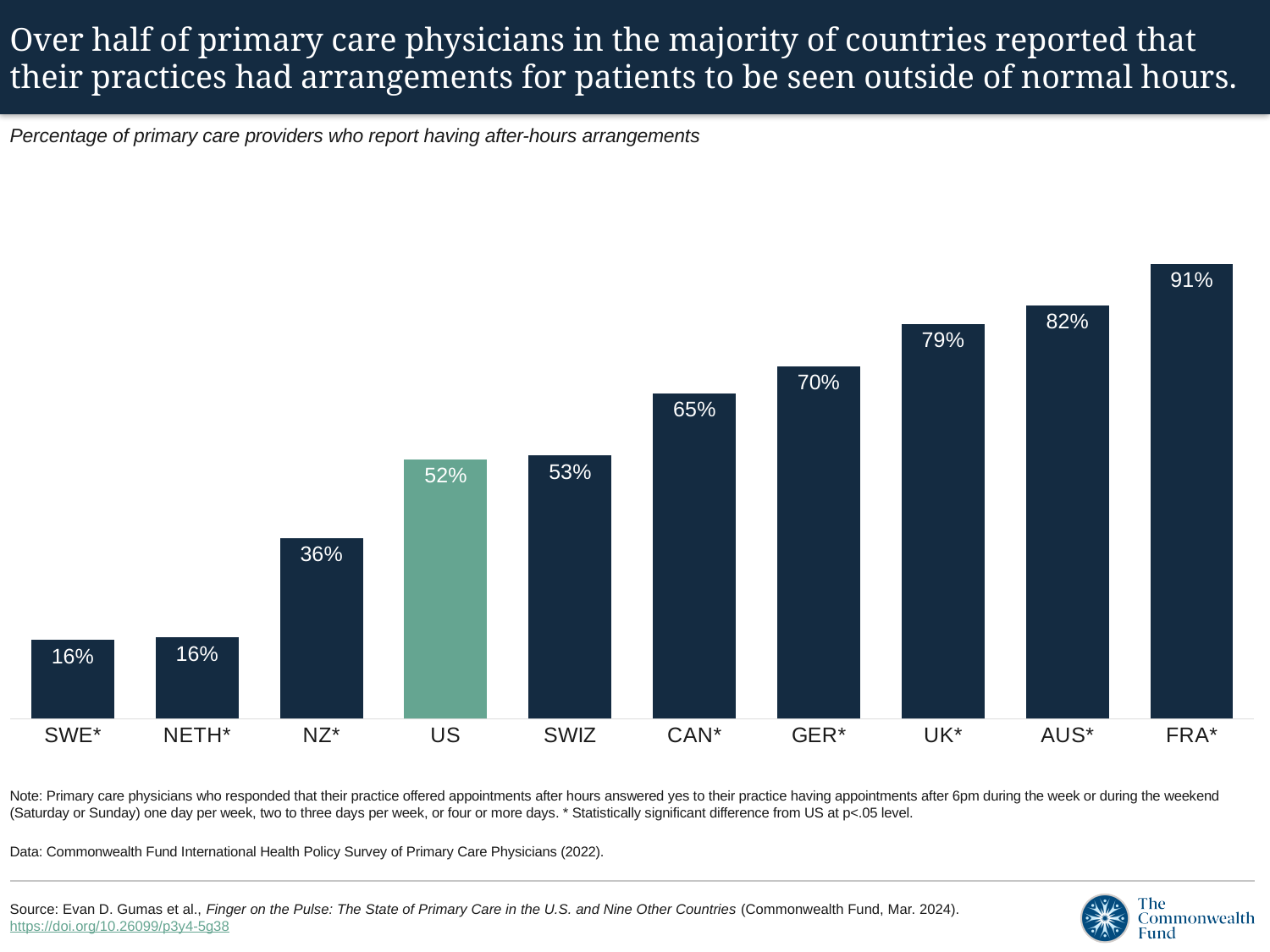
How many countries are shown on the chart? 10 What is the value shown for GER*? 70% Which has a higher value, CAN* or SWIZ? CAN* What percentage of primary care providers in the US report having after-hours arrangements? 52% What is the difference between the values for FRA* and the US? 39 percentage points What kind of chart is shown on the slide? Bar chart Which countries share the lowest value on the chart? SWE* and NETH* What is the value shown for NZ*? 36% Which bar is shown in a different colour (green) from the others? US Do the values rise or fall moving from left to right across the chart? Rise Which country has the highest percentage of primary care providers reporting after-hours arrangements? FRA* What is the difference between the values for AUS* and UK*? 3 percentage points